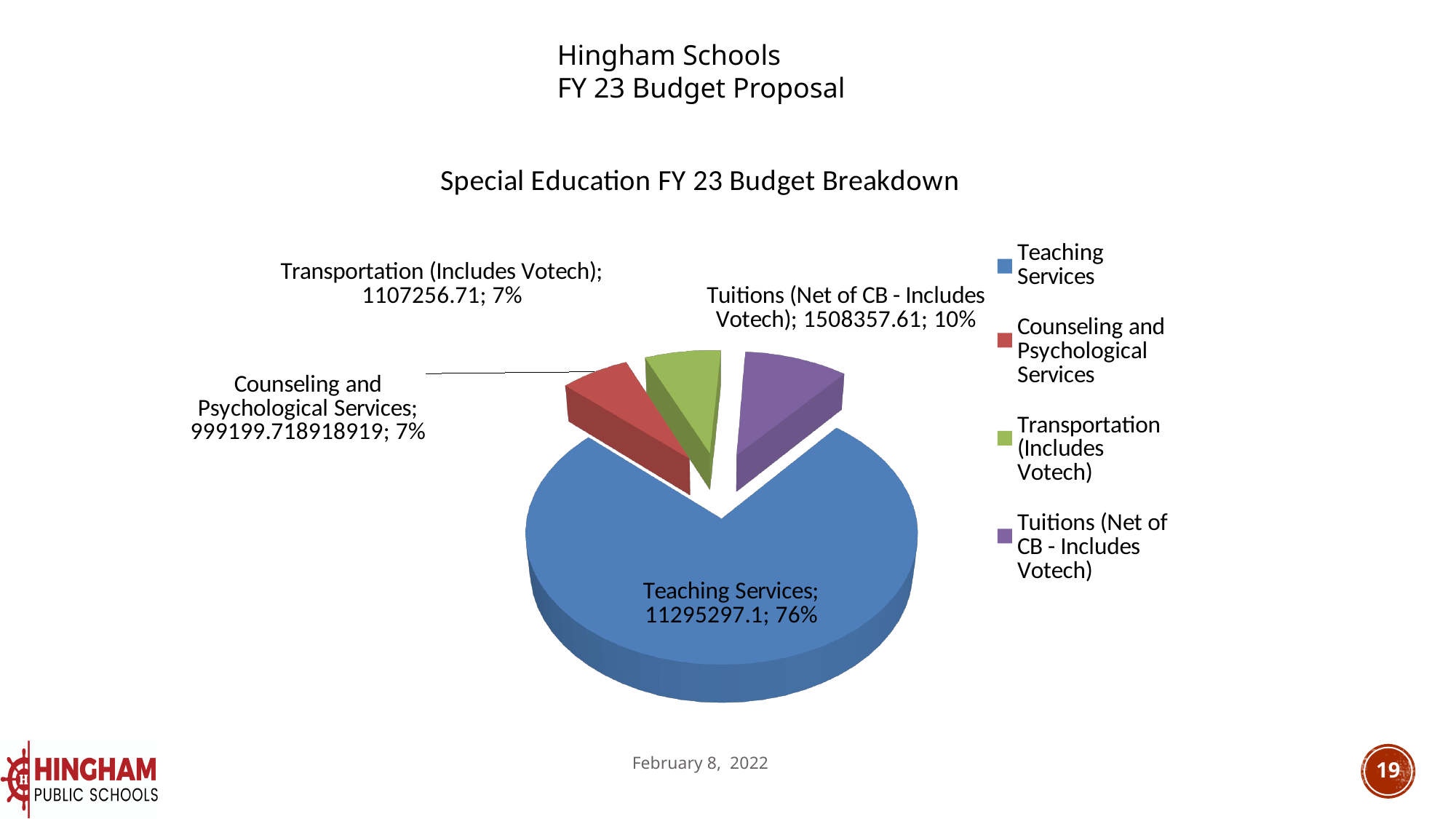
What is the value shown for Tuitions (Net of CB - Includes Votech)? 1508357.61 How many slices does the pie chart have? 4 What percentage share of the pie does Teaching Services represent? 76% What is the value shown for Teaching Services? 11295297.1 How many entries does the legend list? 4 What colour is the Teaching Services slice? blue What is the value shown for Transportation (Includes Votech)? 1107256.71 What percentage share of the pie does Tuitions (Net of CB - Includes Votech) represent? 10% What kind of chart is shown on the slide? pie chart Which category has the largest slice of the pie? Teaching Services Which is larger, Tuitions (Net of CB - Includes Votech) or Transportation (Includes Votech)? Tuitions (Net of CB - Includes Votech) What is the title of the chart? Special Education FY 23 Budget Breakdown